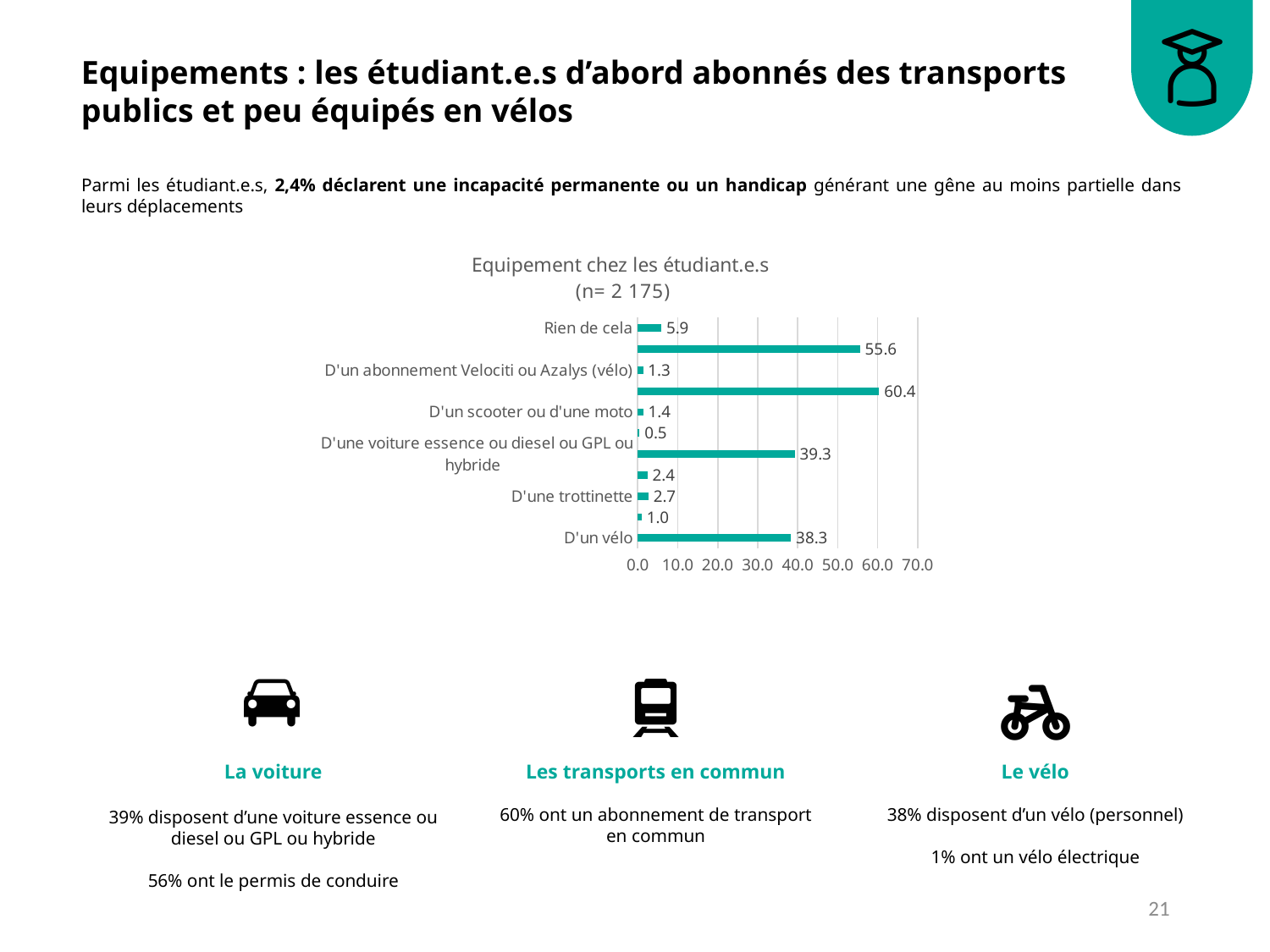
What is the value for 'D'une trottinette'? 2.7 How many bars are plotted in the chart? 11 What is the highest value shown in the chart? 60.4 What is the value for 'D'une voiture essence ou diesel ou GPL ou hybride'? 39.3 What is the value for 'D'un abonnement Velociti ou Azalys (vélo)'? 1.3 What is the title of the chart? Equipement chez les étudiant.e.s (n= 2 175) What is the difference between the values for 'D'une voiture essence ou diesel ou GPL ou hybride' and 'D'un vélo'? 1.0 What is the value for 'D'un scooter ou d'une moto'? 1.4 What is the value for 'D'un vélo'? 38.3 What type of chart is shown on the slide? bar chart Which is larger: the value for 'Rien de cela' or the value for 'D'une trottinette'? Rien de cela What is the value for 'Rien de cela'? 5.9